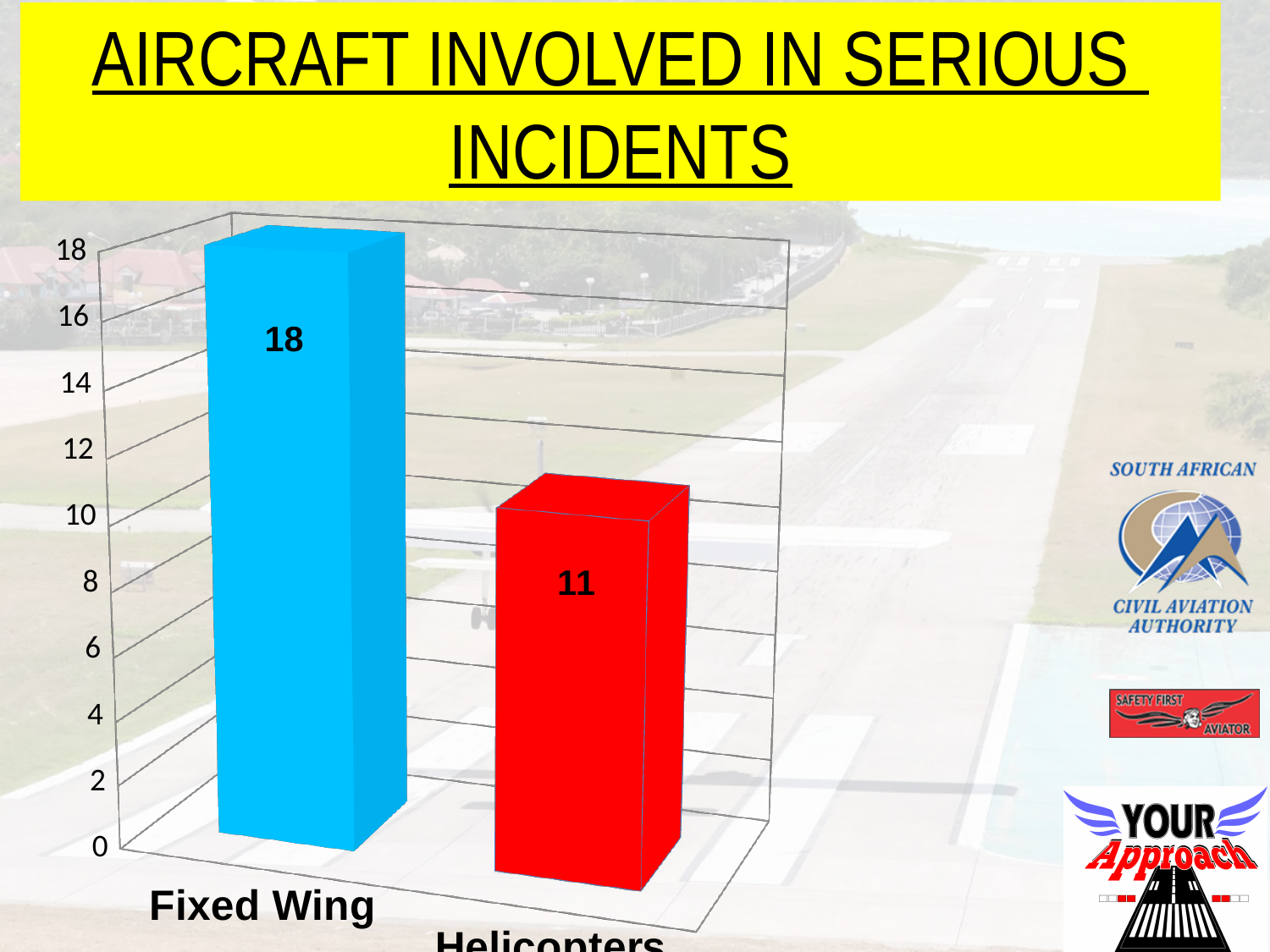
Which is larger, the value for Fixed Wing or the value for Helicopters? Fixed Wing What is the title of the slide? AIRCRAFT INVOLVED IN SERIOUS INCIDENTS What kind of chart is shown on the slide? bar chart What is the value for Fixed Wing? 18 What is the value for Helicopters? 11 Which category has the highest value? Fixed Wing Is the value for Helicopters greater or less than 12? less Is the value for Fixed Wing greater or less than 16? greater What colour is the Helicopters bar? red How many categories are shown in the chart? 2 What is the difference between the Fixed Wing and Helicopters values? 7 Which category has the lowest value? Helicopters